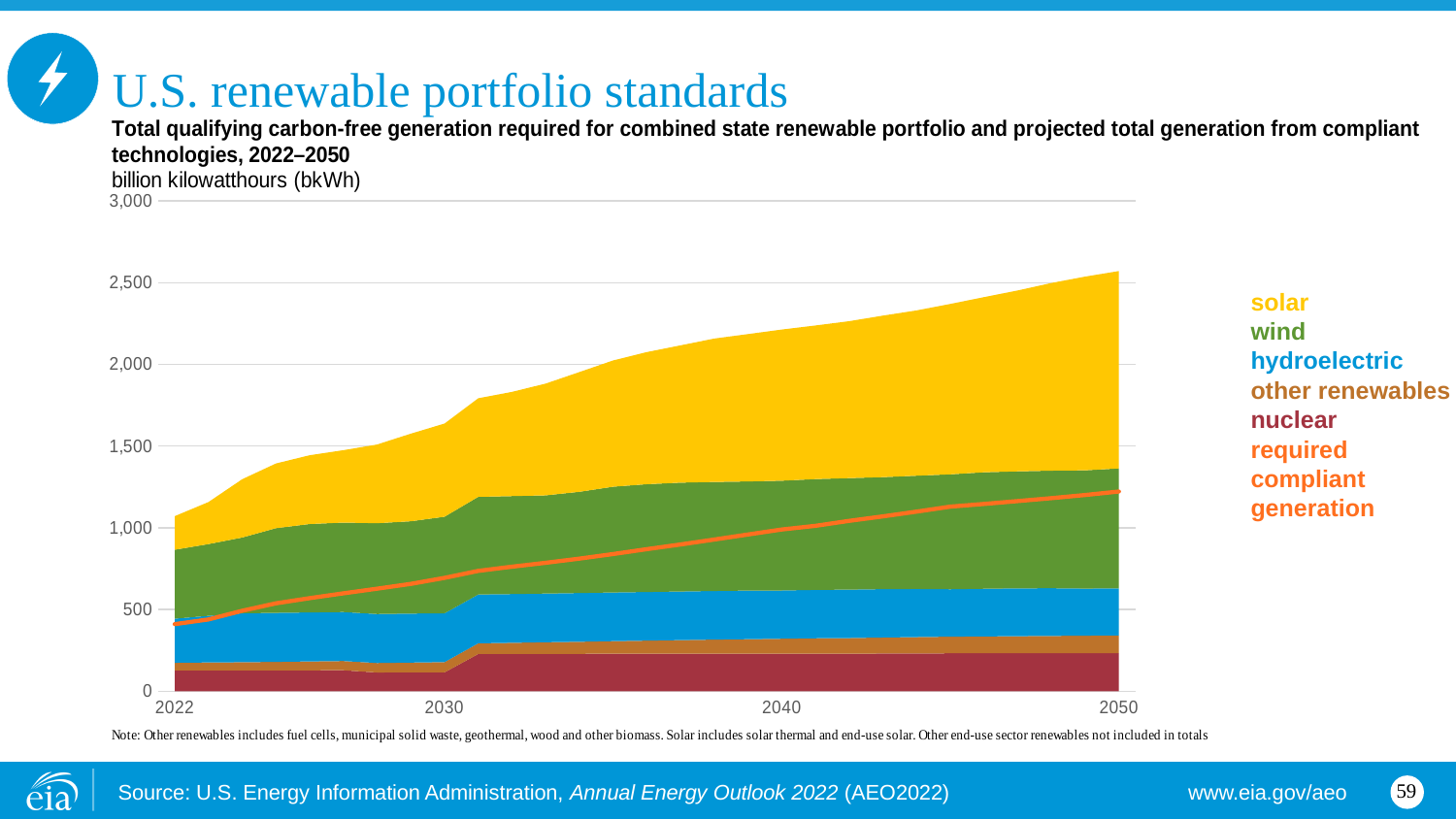
Is the required compliant generation in 2030 greater or less than 500 bkWh? greater Does the required compliant generation line rise or fall from 2022 to 2050? rise Is the required compliant generation in 2022 greater or less than 500 bkWh? less Does the total projected generation from compliant technologies rise or fall from 2022 to 2050? rise How many entries does the legend list? 6 Which legend entry is shown in yellow? solar What is the highest value shown on the y axis? 3,000 What unit is the y axis measured in? billion kilowatthours (bkWh) Is the total projected generation from compliant technologies in 2030 greater or less than 1,500 bkWh? greater What kind of chart is shown on the slide? stacked area chart with a line